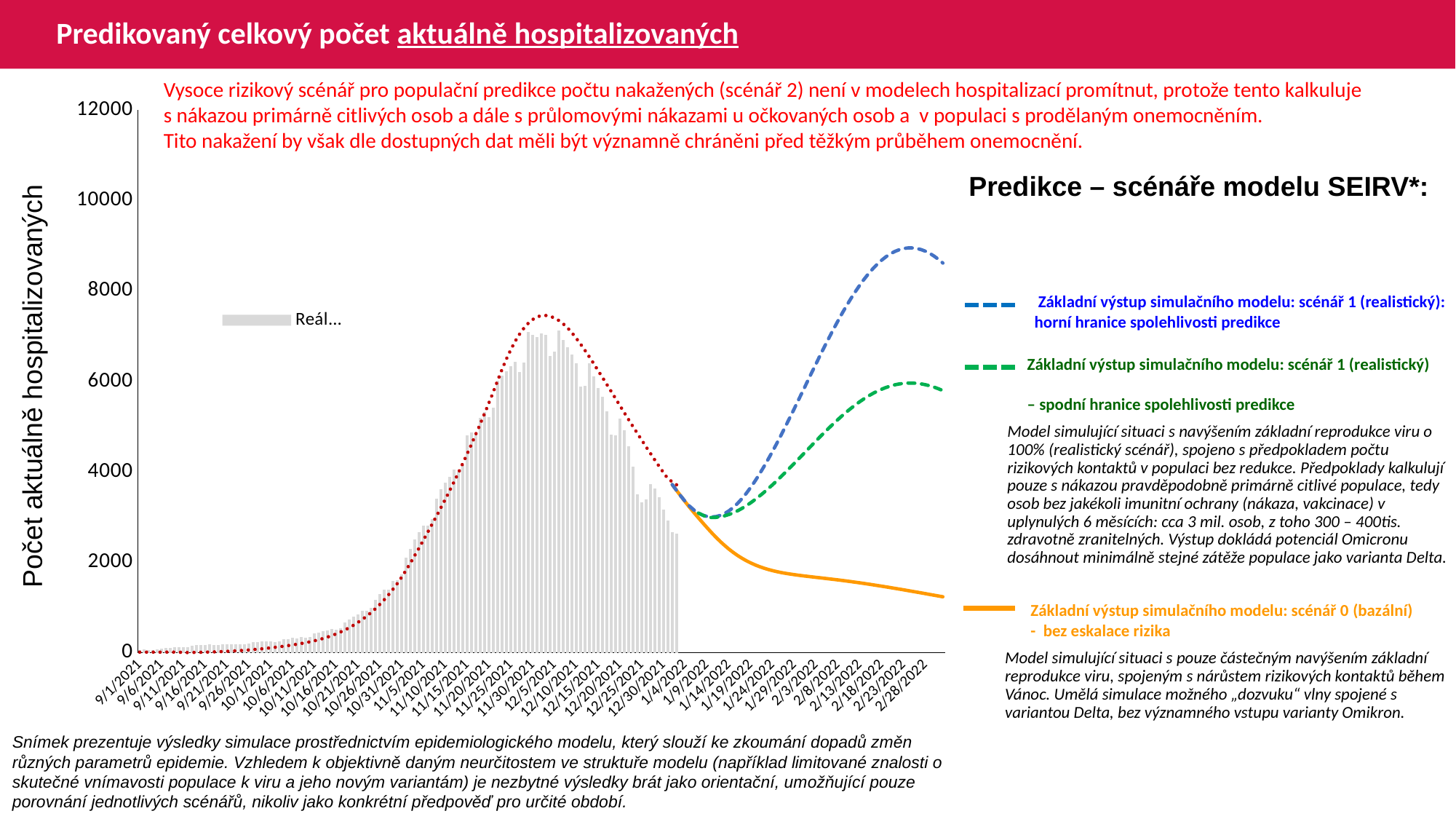
Is the peak of the green dashed line (scenario 1, lower bound) greater or less than 5000? greater Which prediction line is lowest at 2/28/2022: the blue dashed, the green dashed, or the orange line? orange Is the peak of the blue dashed line (scenario 1, upper bound) greater or less than 8000? greater What is the highest value shown on the vertical axis of the chart? 12000 Is the value of the orange line (scenario 0) at 2/28/2022 greater or less than 2000? less Does the blue dashed line rise or fall between 1/14/2022 and 2/18/2022? rise Which prediction line is highest at 2/28/2022: the blue dashed, the green dashed, or the orange line? blue dashed What kind of chart is used to show the real hospitalized values (Reál...)? bar chart What is the label of the vertical axis of the chart? Počet aktuálně hospitalizovaných What is the title of the chart on the slide? Predikovaný celkový počet aktuálně hospitalizovaných Does the orange line (scenario 0) rise or fall between 1/9/2022 and 2/28/2022? fall